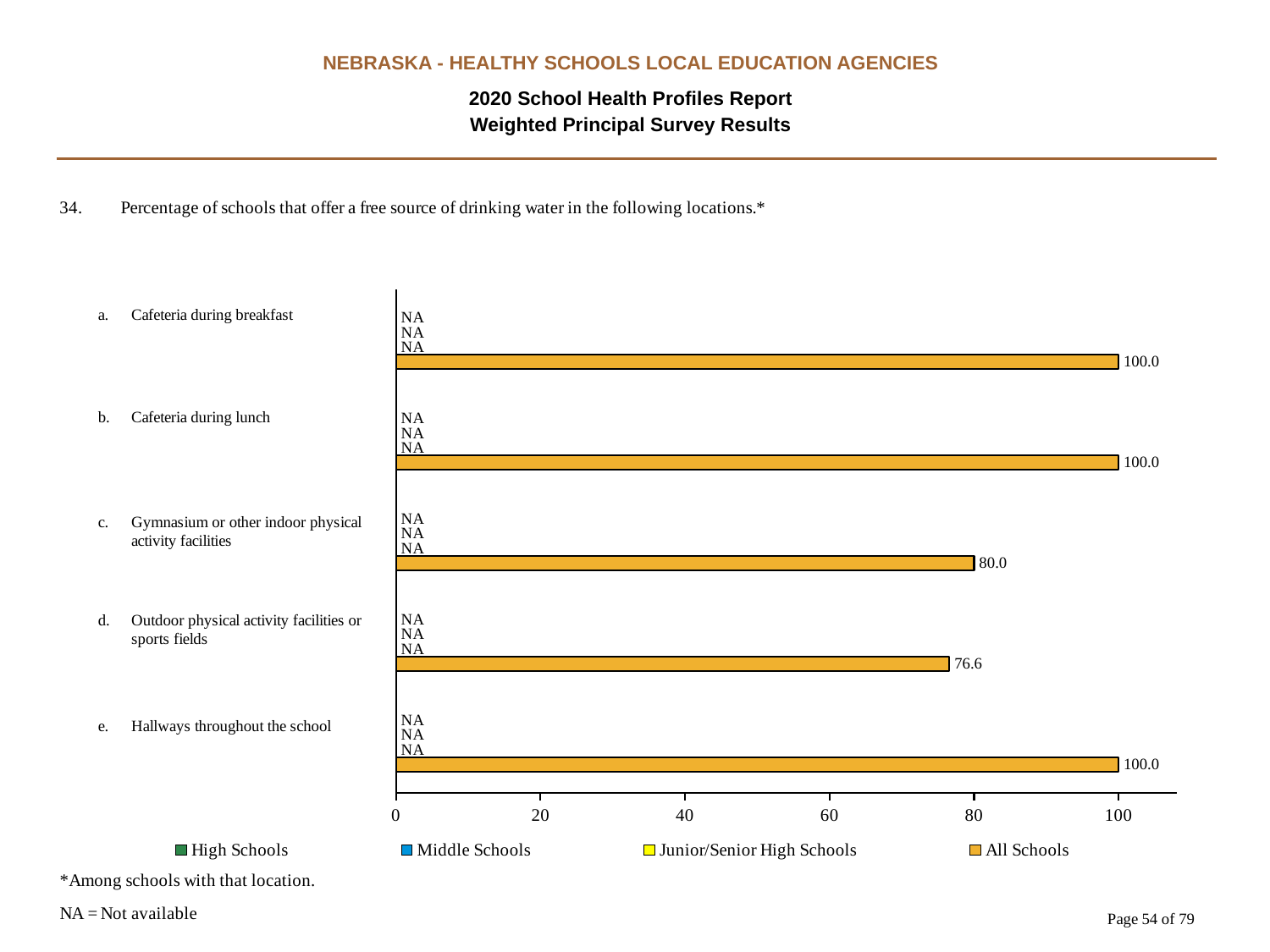
What kind of chart is shown on the slide? bar chart How many locations (categories) are shown in the chart? 5 What is the All Schools value for 'Gymnasium or other indoor physical activity facilities'? 80.0 What is the All Schools value for 'Cafeteria during breakfast'? 100.0 Is the All Schools value for 'Outdoor physical activity facilities or sports fields' greater or less than 80? less Which is larger for All Schools: 'Gymnasium or other indoor physical activity facilities' or 'Outdoor physical activity facilities or sports fields'? Gymnasium or other indoor physical activity facilities What value is shown for High Schools for 'Cafeteria during lunch'? NA What is the All Schools value for 'Hallways throughout the school'? 100.0 What is the All Schools value for 'Outdoor physical activity facilities or sports fields'? 76.6 How many series does the legend list? 4 What is the difference between the All Schools values for 'Cafeteria during lunch' and 'Outdoor physical activity facilities or sports fields'? 23.4 Which location has the lowest All Schools value? Outdoor physical activity facilities or sports fields